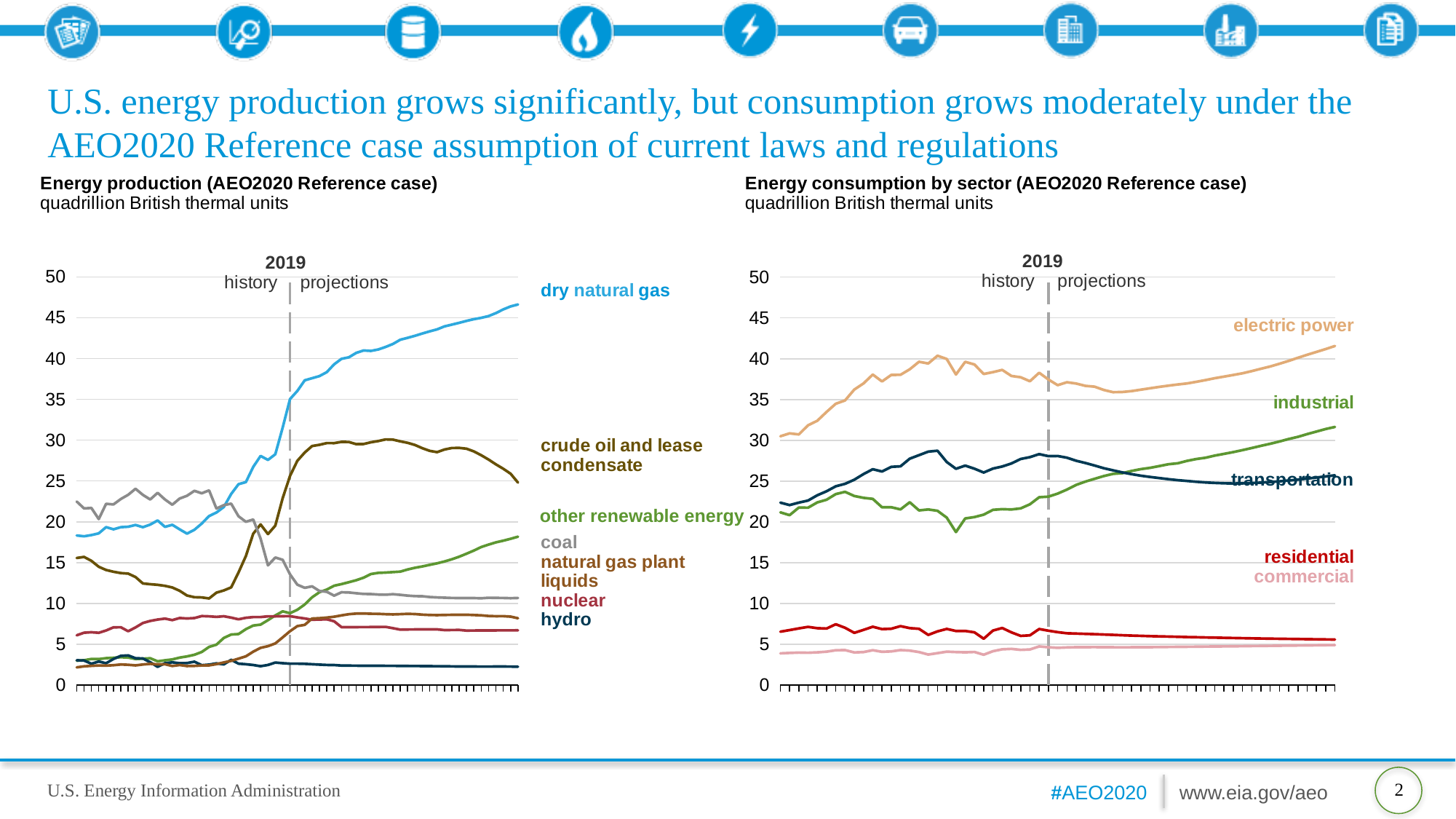
In the Energy production chart, does the coal series rise or fall over the history period? fall What unit is used on the y axis of both charts? quadrillion British thermal units In the Energy production chart, which series has the lowest value at the end of the projection period? hydro In the Energy production chart, which series has the highest value at the end of the projection period? dry natural gas In the Energy consumption by sector chart, is the value for electric power at the end of the projection period greater or less than 40? greater In the Energy consumption by sector chart, is the value for electric power or industrial larger at the end of the projection period? electric power What kind of chart is the Energy production (AEO2020 Reference case) chart? line chart In the Energy production chart, is the value for dry natural gas at the end of the projection period greater or less than 45? greater In the Energy consumption by sector chart, is the value for industrial at the end of the projection period greater or less than 30? greater How many sectors are labelled on the Energy consumption by sector (AEO2020 Reference case) chart? 5 In the Energy consumption by sector chart, which sector has the highest value at the end of the projection period? electric power How many series are labelled on the Energy production (AEO2020 Reference case) chart? 7